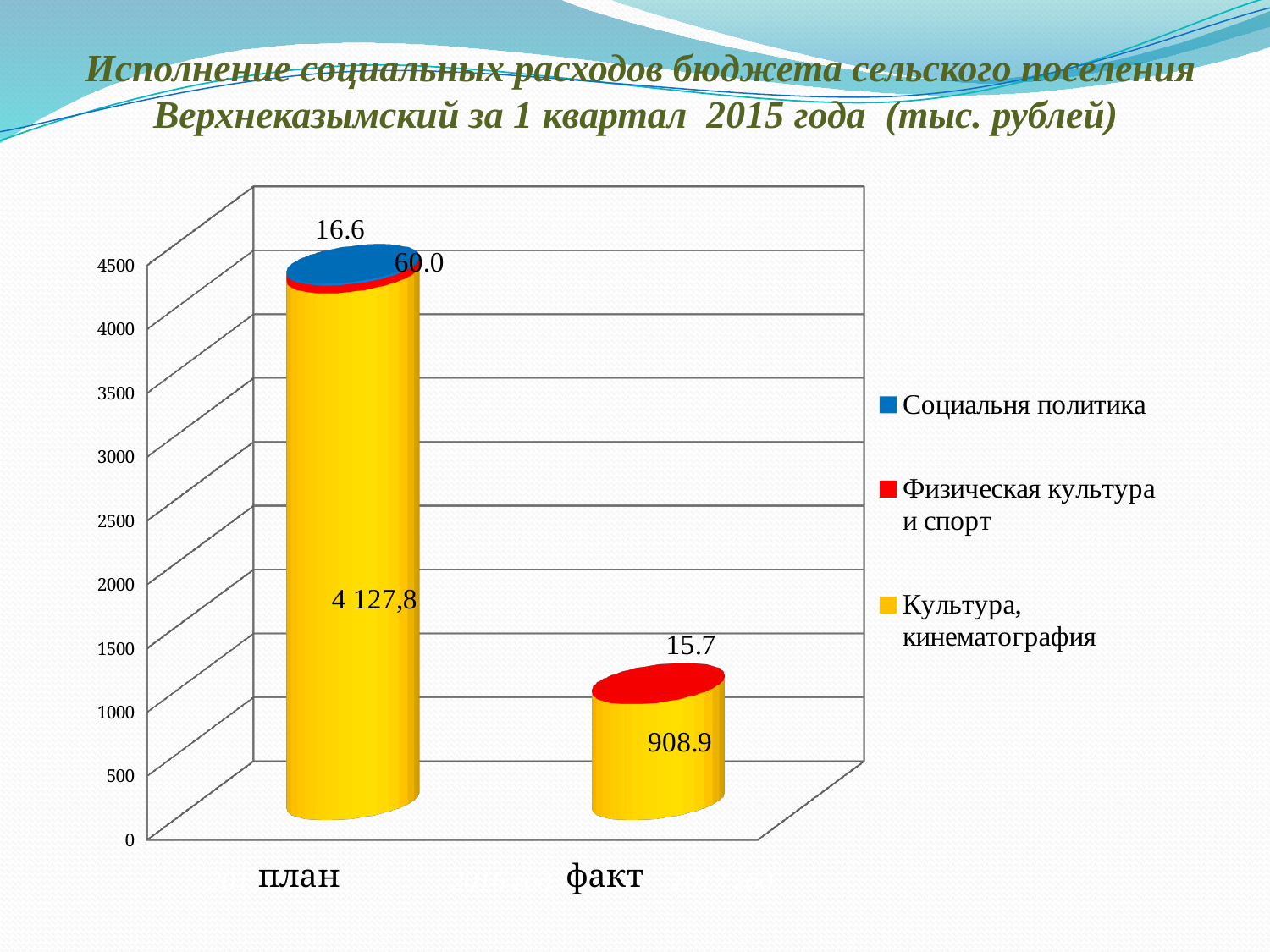
Which series is shown in yellow in the legend? Культура, кинематография Which series is shown in blue in the legend? Социальня политика What is the value for Социальня политика in the план bar? 16.6 What is the value for Физическая культура и спорт in the план bar? 60.0 What is the difference between the Физическая культура и спорт values for план and факт? 44.3 How many categories are shown on the x axis? 2 What is the value for Культура, кинематография in the план bar? 4 127,8 What is the value for Физическая культура и спорт in the факт bar? 15.7 Which category has the taller bar, план or факт? план What is the value for Культура, кинематография in the факт bar? 908.9 What kind of chart is shown on the slide? bar chart How many series does the legend list? 3